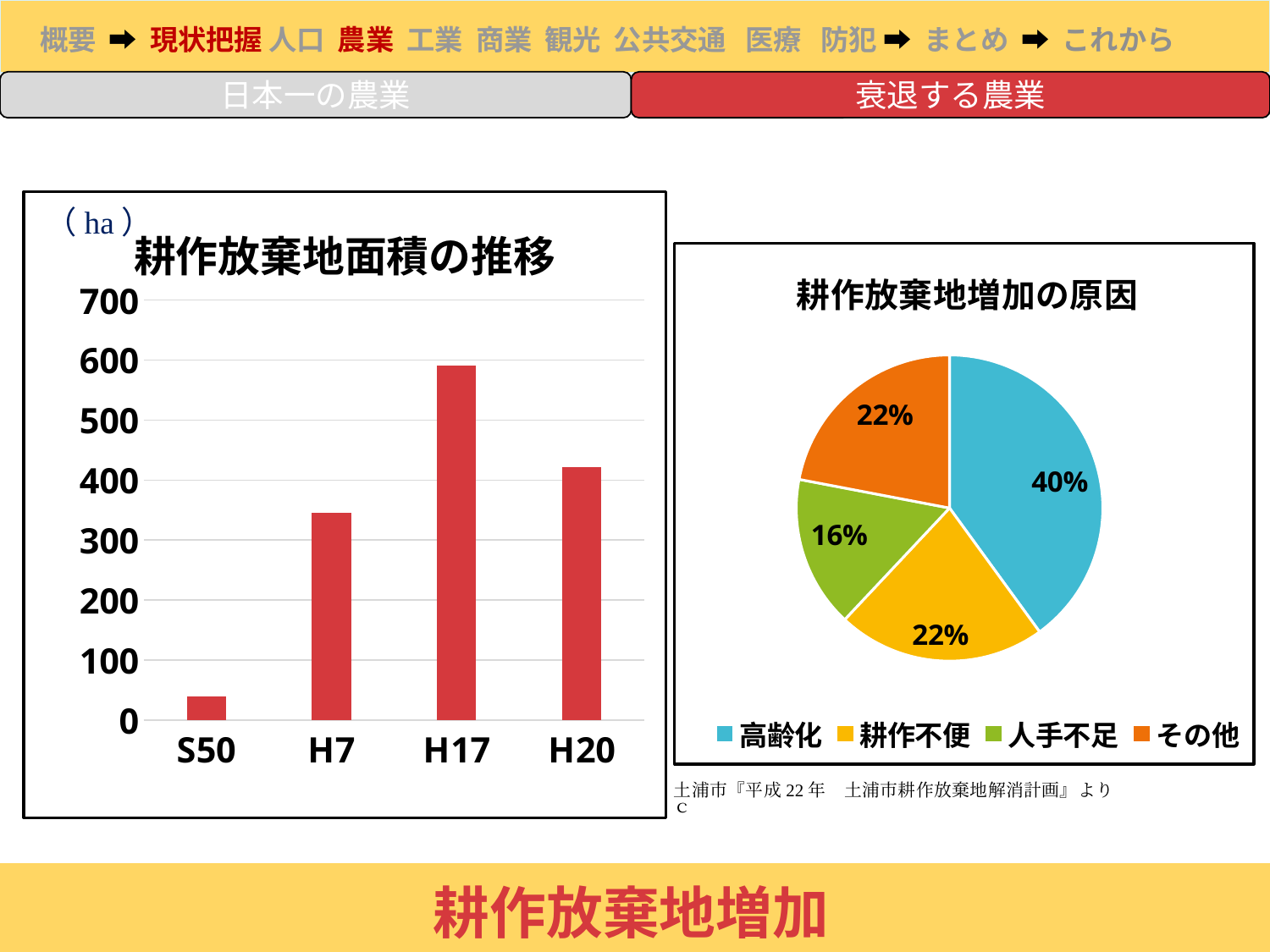
In the bar chart 耕作放棄地面積の推移, is the value for H20 greater or less than 400? greater What kind of chart is the left chart titled 耕作放棄地面積の推移? bar chart In the bar chart 耕作放棄地面積の推移, which category has the lowest value? S50 How many entries does the legend of the pie chart 耕作放棄地増加の原因 list? 4 In the pie chart 耕作放棄地増加の原因, which category has the smallest share? 人手不足 In the pie chart 耕作放棄地増加の原因, what share does 高齢化 have? 40% In the bar chart 耕作放棄地面積の推移, is the value for S50 greater or less than 100? less In the pie chart 耕作放棄地増加の原因, what is the difference between the share of 高齢化 and the share of 人手不足? 24% In the bar chart 耕作放棄地面積の推移, which category has the highest value? H17 In the bar chart 耕作放棄地面積の推移, which is larger, the value for H7 or the value for H20? H20 In the bar chart 耕作放棄地面積の推移, do the values rise or fall from S50 to H17? rise How many categories are shown on the x axis of the bar chart 耕作放棄地面積の推移? 4